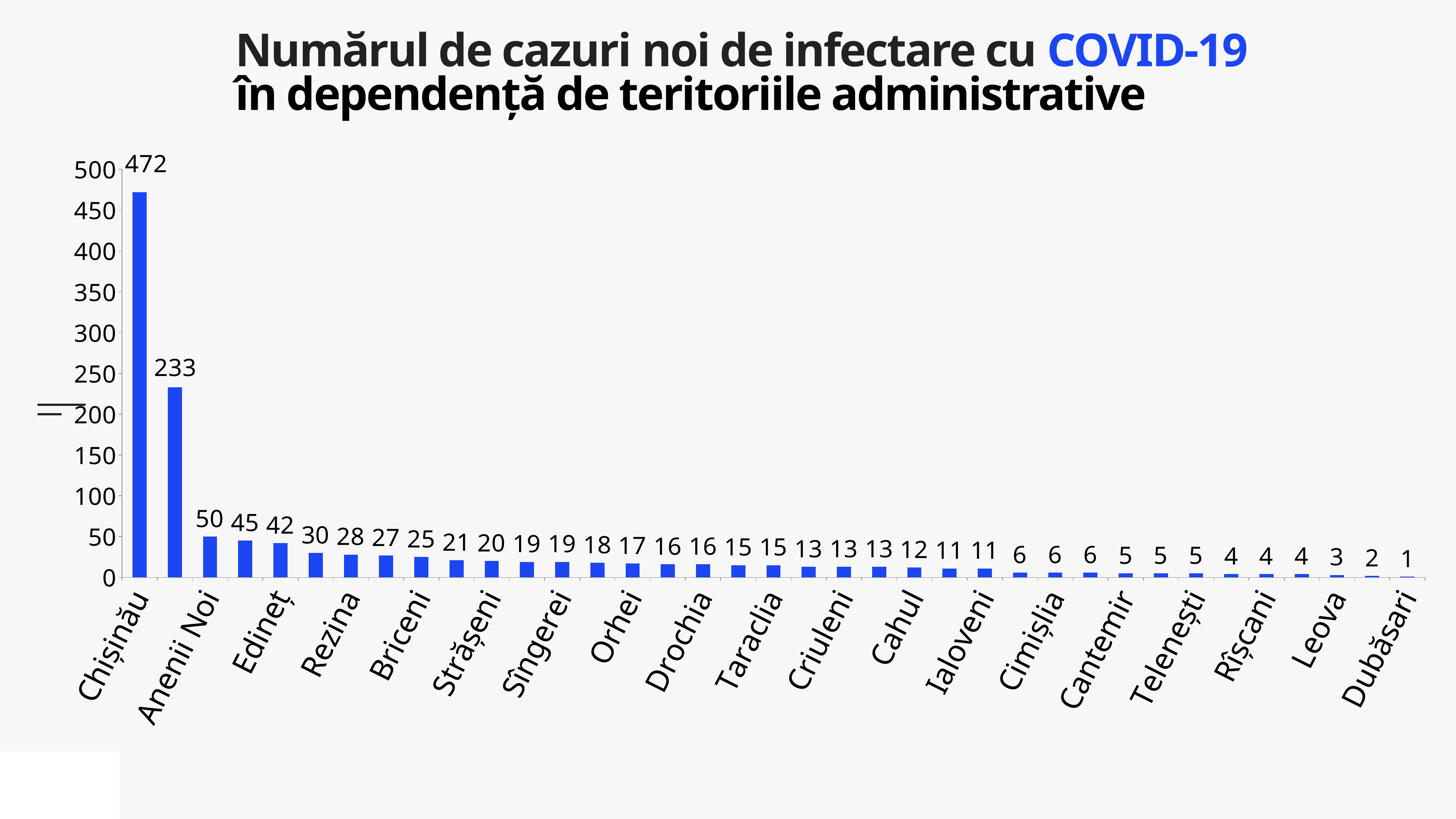
Which territory has the lowest number of new cases? Dubăsari What is the difference between the values for Chișinău and Dubăsari? 471 Which is larger, the value for Chișinău or the value for Anenii Noi? Chișinău What is the value for Chișinău? 472 What is the value for Anenii Noi? 50 What colour are the bars in the chart? Blue What is the value for Dubăsari? 1 Do the values rise or fall from left to right along the x axis? Fall Which territory has the highest number of new cases? Chișinău What is the value for Edineț? 42 Is the value for Chișinău greater or less than 450? greater What kind of chart is shown on the slide? Bar chart